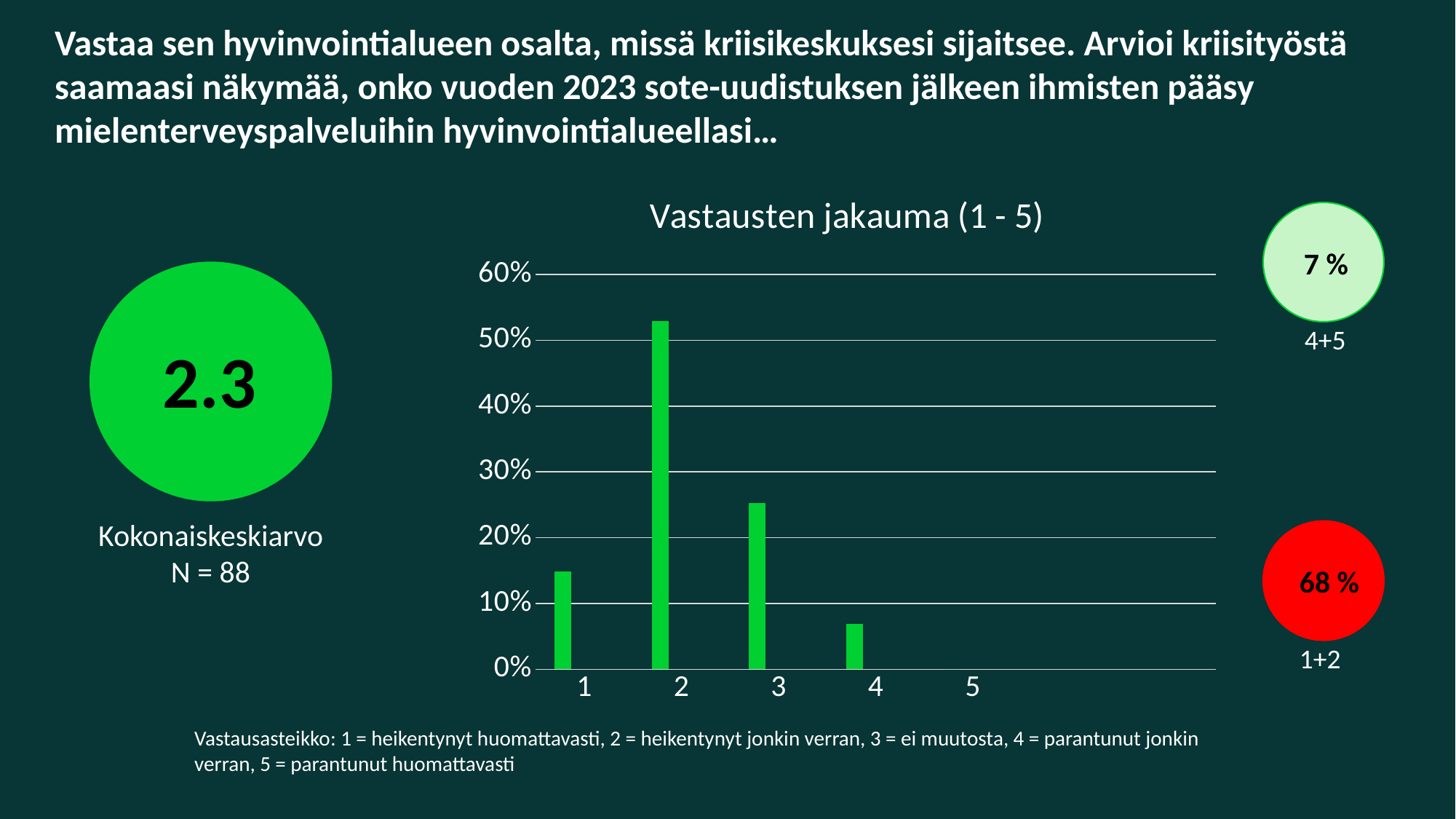
Which category has the highest value in the chart? 2 How many categories are shown on the x axis of the chart? 5 What kind of chart is shown on the slide? bar chart Is the value for category 1 greater or less than 10%? greater What is the highest value shown on the y axis of the chart? 60% Is the value for category 4 greater or less than 10%? less Is the value for category 3 greater or less than 30%? less Which category has a larger value, 1 or 3? 3 Which category has the lowest value in the chart? 5 What is the title of the chart? Vastausten jakauma (1 - 5)